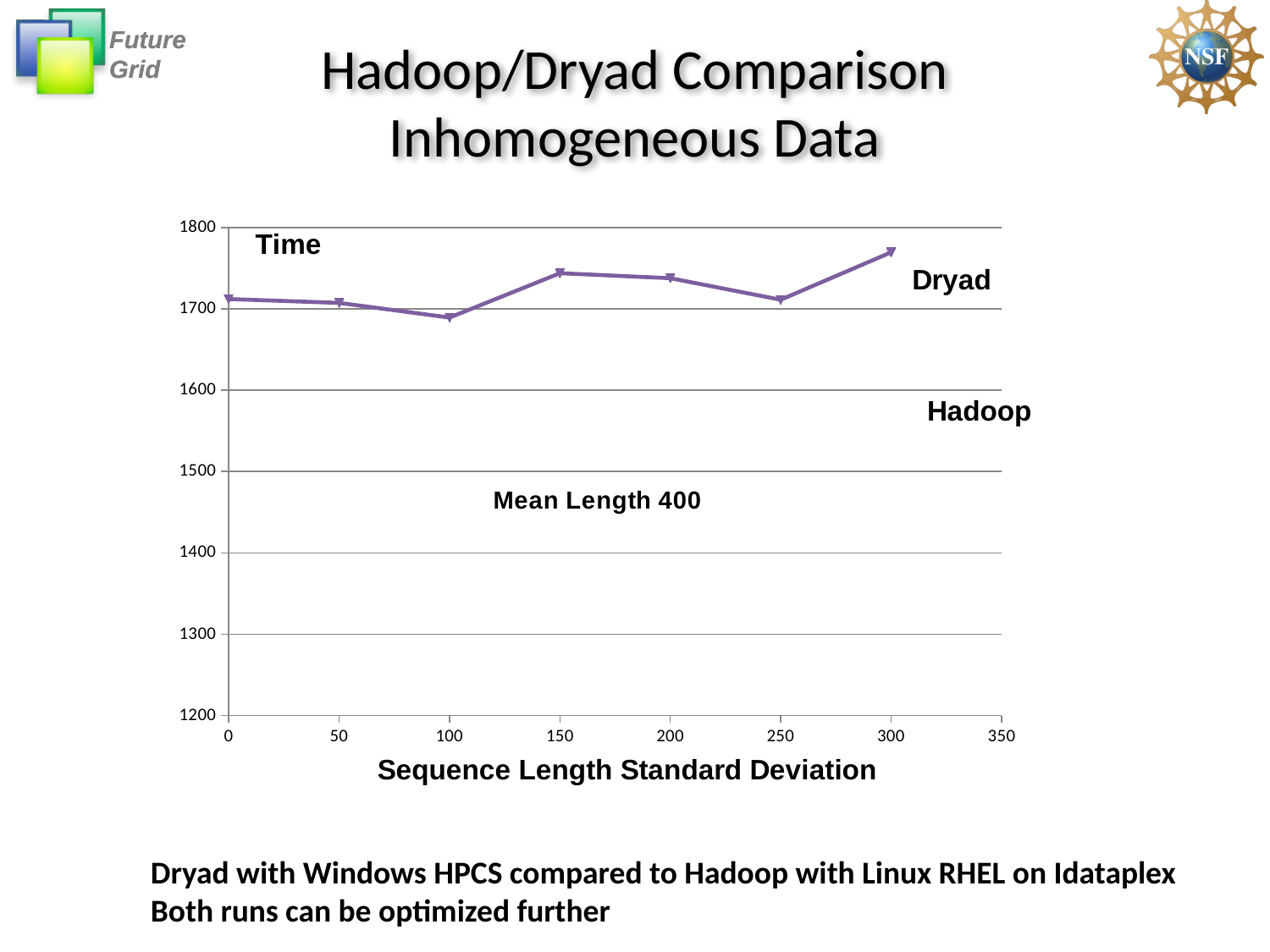
Is the value of the plotted line at a standard deviation of 100 greater or less than 1700? less Which is larger, the value of the plotted line at a standard deviation of 100 or at 150? 150 At which sequence length standard deviation does the plotted line reach its lowest value? 100 Does the plotted line rise or fall between a standard deviation of 0 and 100? fall At which sequence length standard deviation does the plotted line reach its highest value? 300 How many data points are plotted on the line? 7 Which is larger, the value of the plotted line at a standard deviation of 250 or at 300? 300 Is the value of the plotted line at a standard deviation of 300 greater or less than 1800? less Is the value of the plotted line at a standard deviation of 150 greater or less than 1700? greater What is the title of the x axis? Sequence Length Standard Deviation What mean length is stated in the annotation inside the chart? Mean Length 400 What kind of chart is shown on the slide? line chart